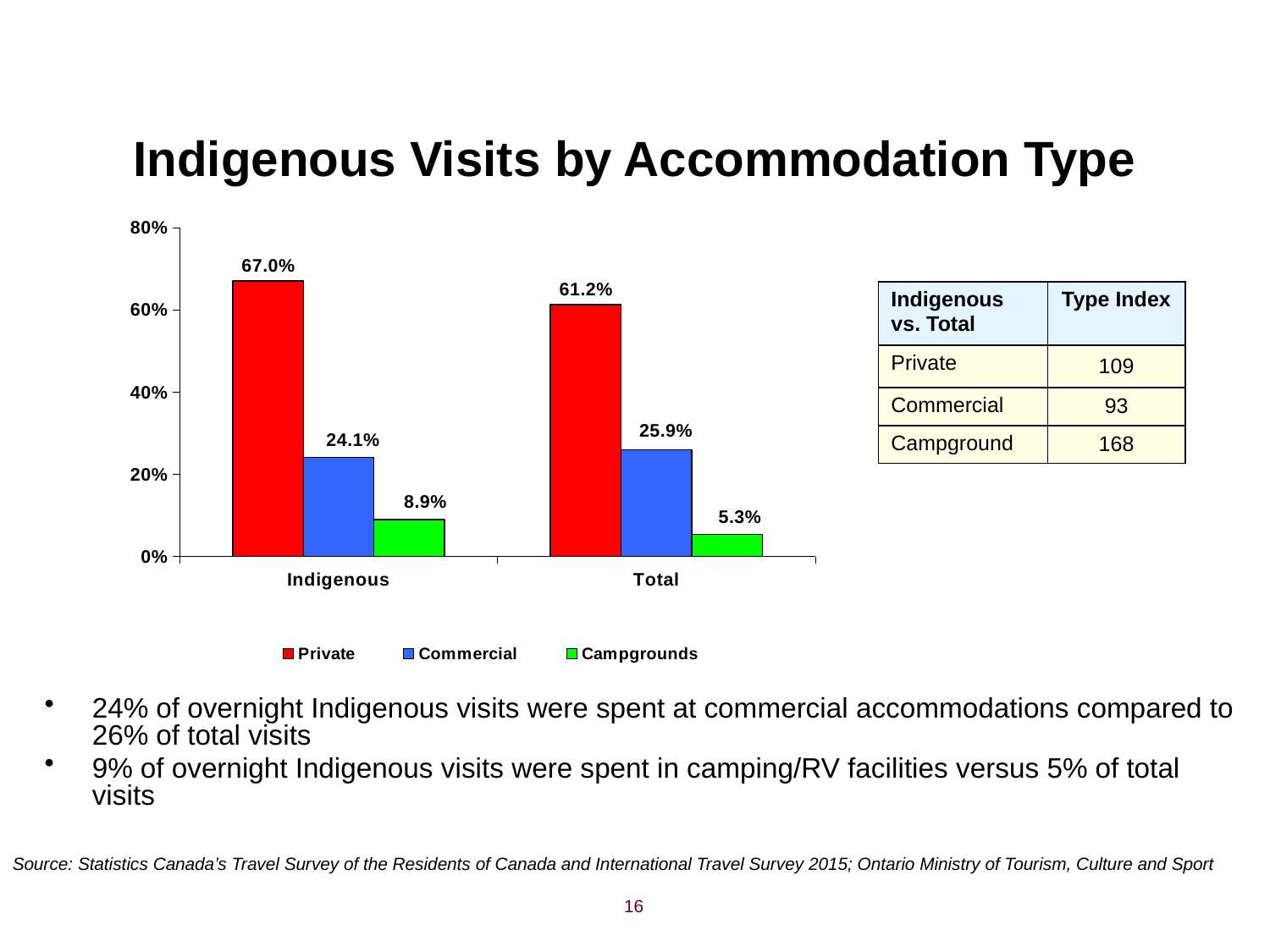
Which is larger, the Commercial value for Indigenous or for Total? Total What is the value for Campgrounds in the Total group? 5.3% What is the value for Commercial in the Indigenous group? 24.1% Is the Campgrounds value for Indigenous greater or less than 20%? less What colour are the Campgrounds bars? green What kind of chart is shown? bar chart What is the difference between the Private values for Indigenous and Total? 5.8 percentage points How many series does the legend list? 3 What is the value for Private in the Indigenous group? 67.0% How many categories are shown on the x axis? 2 Which series has the lowest value in the Indigenous group? Campgrounds Which series has the highest value in the Total group? Private